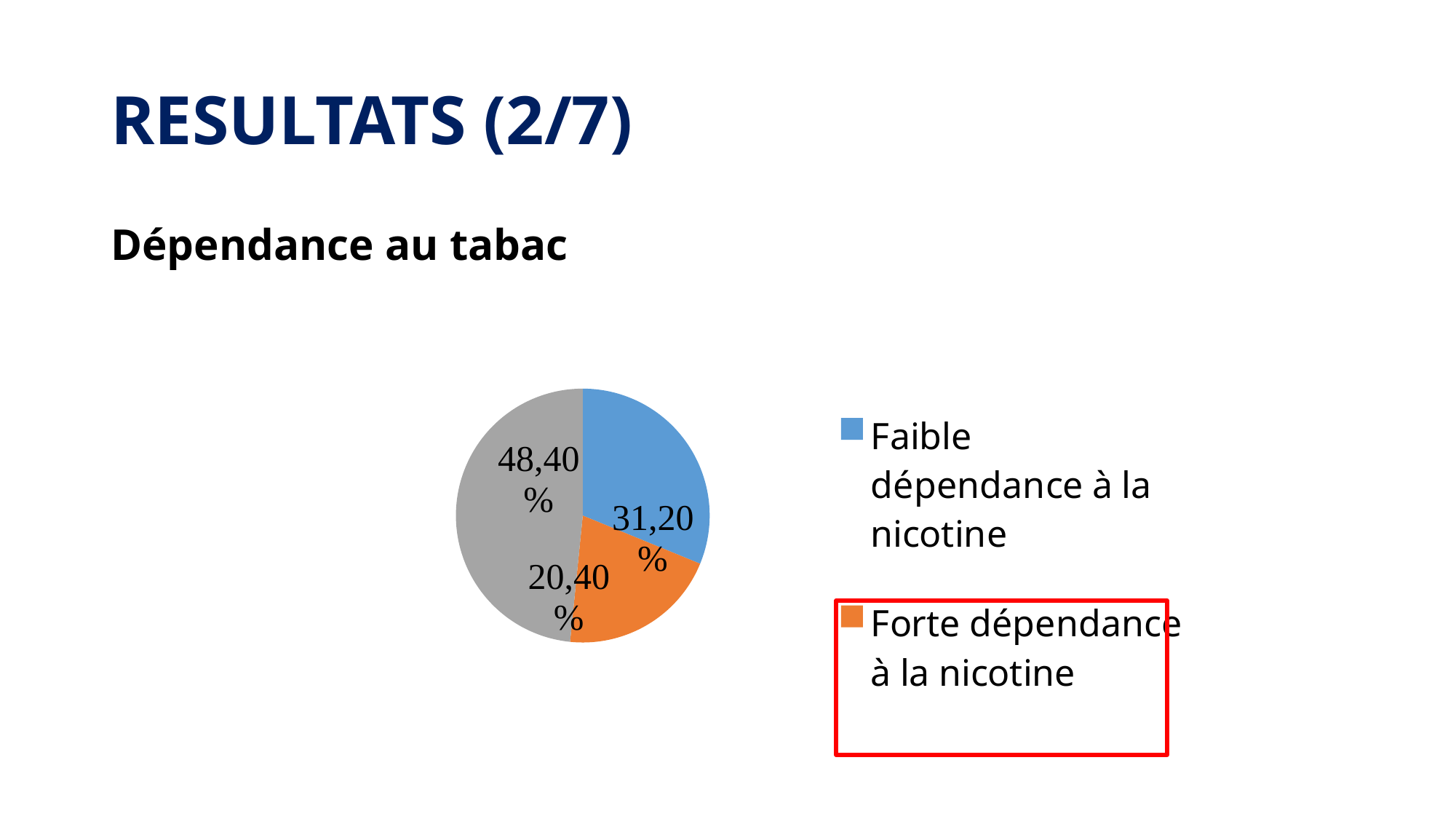
Is the value for 'Faible dépendance à la nicotine' greater or less than 30%? greater What is the difference in percentage points between 'Faible dépendance à la nicotine' and 'Forte dépendance à la nicotine'? 10,80 Which slice is larger: 'Faible dépendance à la nicotine' or 'Forte dépendance à la nicotine'? Faible dépendance à la nicotine What kind of chart is shown on the slide? Pie chart What colour is the slice for 'Forte dépendance à la nicotine'? Orange What is the largest percentage shown on the pie chart? 48,40% What is the heading above the chart? Dépendance au tabac What percentage of the pie chart corresponds to 'Faible dépendance à la nicotine'? 31,20% How many slices does the pie chart have? 3 How many entries does the legend list? 2 Which legend category has the smallest slice of the pie chart? Forte dépendance à la nicotine What percentage of the pie chart corresponds to 'Forte dépendance à la nicotine'? 20,40%